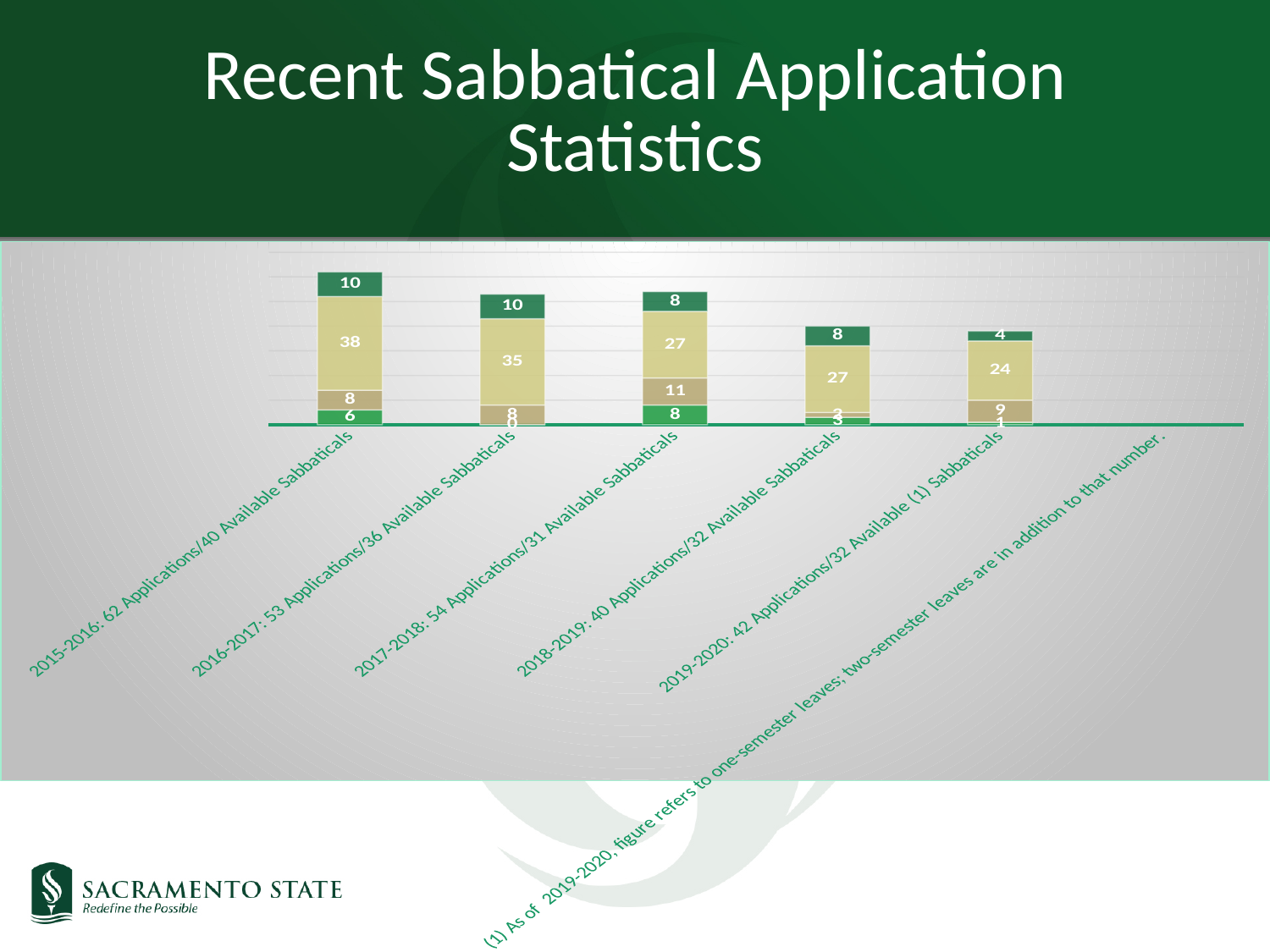
What is the value of the top (dark green) segment in the 2017-2018 bar? 8 What is the difference between the largest segment of the 2015-2016 bar (38) and the largest segment of the 2016-2017 bar (35)? 3 What is the total of the 2015-2016 stacked bar? 62 What is the title of the slide containing the chart? Recent Sabbatical Application Statistics What is the total of the 2017-2018 stacked bar? 54 What is the value of the top (dark green) segment in the 2019-2020 bar? 4 What kind of chart is shown on the slide? stacked bar chart What is the value of the largest (light tan) segment in the 2015-2016 bar? 38 What is the value of the largest (light tan) segment in the 2019-2020 bar? 24 Which is larger: the largest segment of the 2015-2016 bar or the largest segment of the 2016-2017 bar? 2015-2016 Which year has the tallest stacked bar? 2015-2016 How many stacked bars are plotted in the chart? 5